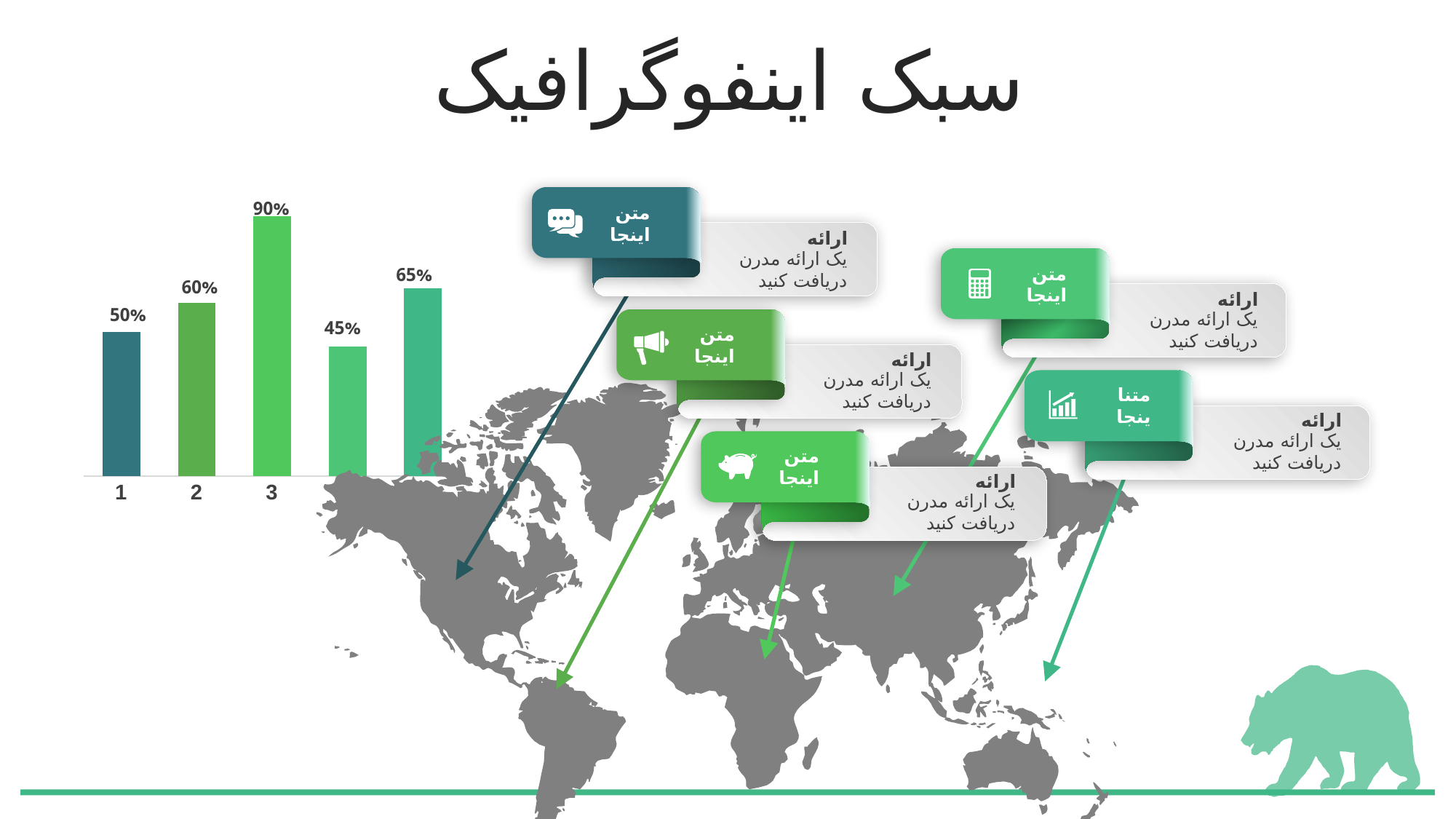
What type of chart is shown on the left of the slide? bar chart What is the difference between the values of category 3 and category 1? 40% Do the bar values rise or fall from category 1 to category 3? rise How many bars does the bar chart have? 5 Which bar has the lowest value? the fourth bar (45%) What is the value of the bar for category 1? 50% Which is larger, the value for category 2 or the value of the rightmost bar? the rightmost bar (65%) Which category has the highest bar? 3 What is the value of the fourth bar from the left? 45% What is the value of the bar for category 3? 90% What is the value of the fifth (rightmost) bar? 65% What is the value of the bar for category 2? 60%